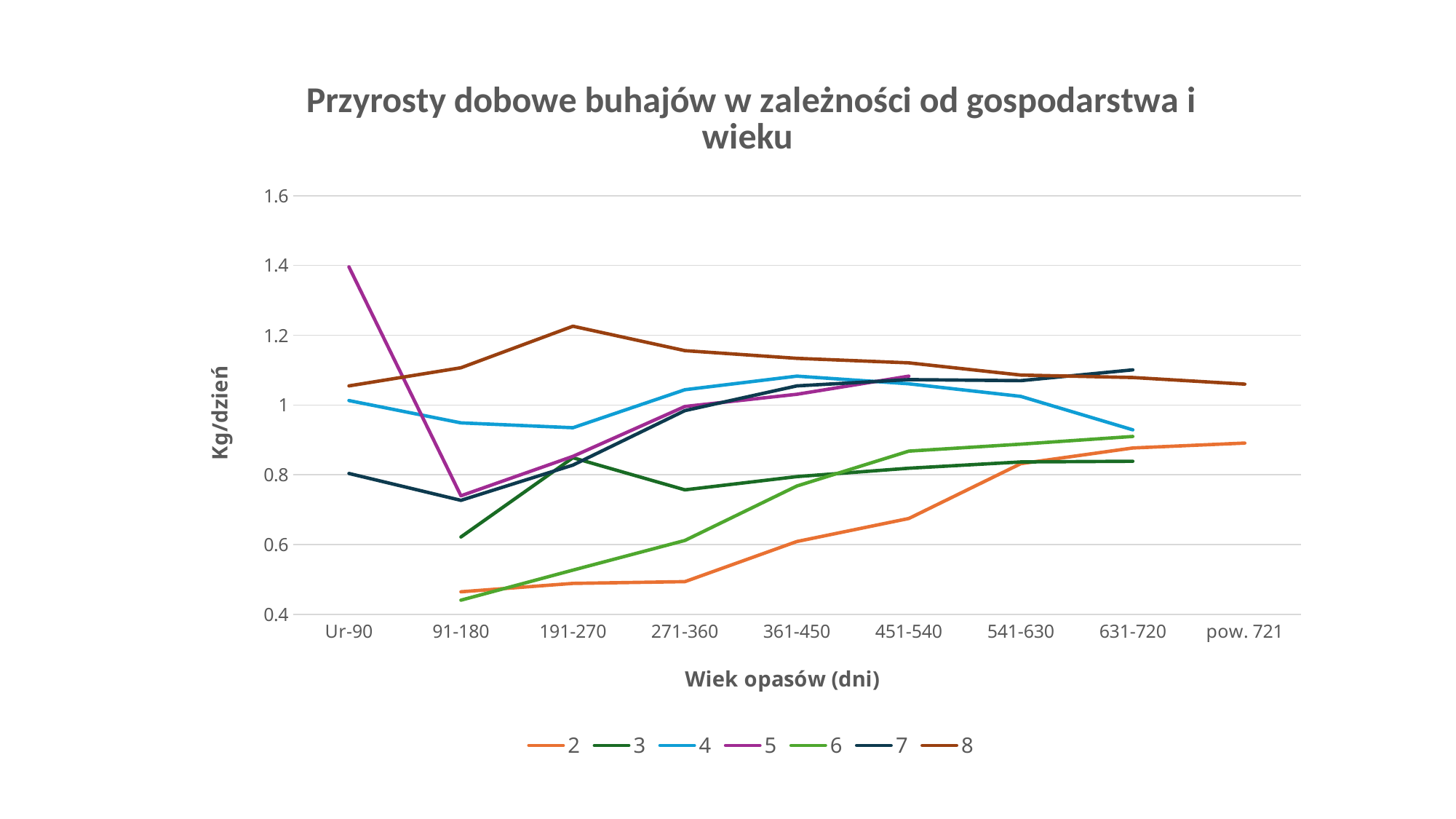
Does the value for series 2 generally rise or fall from Ur-90 to pow. 721? rise What kind of chart is shown on the slide? line chart Which series has the lowest value at 271-360? 2 Is the value for series 5 at Ur-90 greater or less than 1.2? greater Is the value for series 6 at 91-180 greater or less than 0.6? less Which series has the highest value at Ur-90? 5 At 361-450, which is larger: the value for series 4 or the value for series 2? series 4 How many age categories are shown on the x axis? 9 How many series does the legend list? 7 What is the label of the y axis? Kg/dzień Which series has the lowest value at Ur-90? 7 Which series has the highest value at 191-270? 8